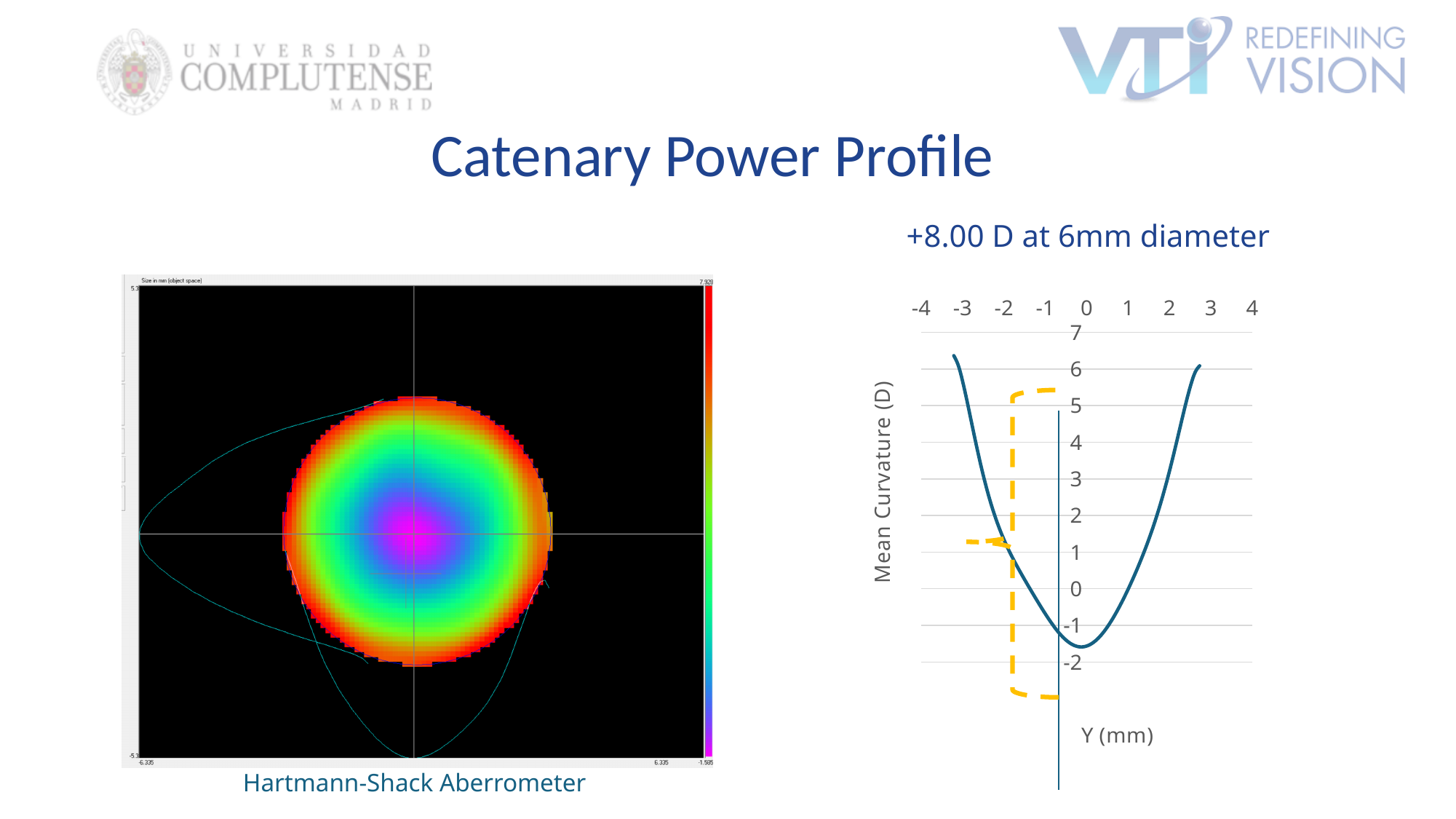
In the right-hand chart, is the lowest point of the solid curve greater or less than -1? less In the right-hand chart, how many lines are plotted? 1 In the right-hand chart, does the solid curve rise or fall as Y goes from -3 mm to 0 mm? fall In the right-hand chart, what is the label of the horizontal axis? Y (mm) What kind of chart is shown on the right side of the slide? line chart In the right-hand chart, is the value of the solid curve at Y = -3 mm greater or less than 5? greater In the right-hand chart, does the solid curve rise or fall as Y goes from 0 mm to 3 mm? rise In the right-hand chart, which is larger: the solid curve's value at Y = -3 mm or at Y = 0 mm? Y = -3 mm In the right-hand chart, is the value of the solid curve at Y = -2 mm greater or less than 1? greater In the right-hand chart, what is the label of the vertical axis? Mean Curvature (D)